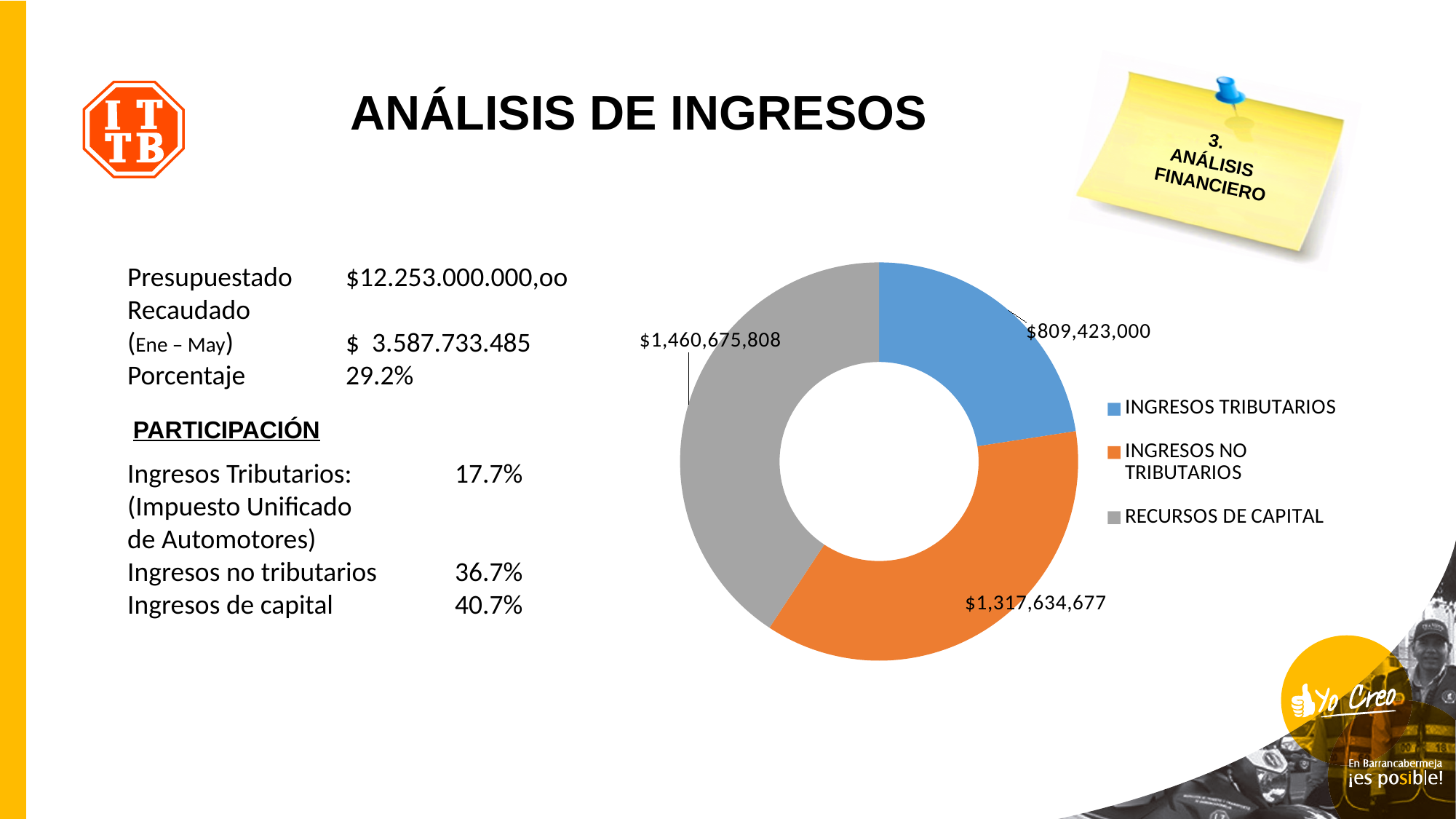
What is the value shown for RECURSOS DE CAPITAL in the doughnut chart? $1,460,675,808 Which category has the smallest value in the doughnut chart? INGRESOS TRIBUTARIOS What is the value shown for INGRESOS TRIBUTARIOS in the doughnut chart? $809,423,000 What is the difference between the values for RECURSOS DE CAPITAL and INGRESOS NO TRIBUTARIOS? $143,041,131 What is the total of the three values shown in the doughnut chart? $3,587,733,485 How many categories are shown in the doughnut chart? 3 What colour represents RECURSOS DE CAPITAL in the chart? gray What is the difference between the values for INGRESOS NO TRIBUTARIOS and INGRESOS TRIBUTARIOS? $508,211,677 What is the value shown for INGRESOS NO TRIBUTARIOS in the doughnut chart? $1,317,634,677 Which is larger, the value for INGRESOS NO TRIBUTARIOS or the value for INGRESOS TRIBUTARIOS? INGRESOS NO TRIBUTARIOS Which category has the largest value in the doughnut chart? RECURSOS DE CAPITAL What kind of chart is shown on the slide? doughnut chart